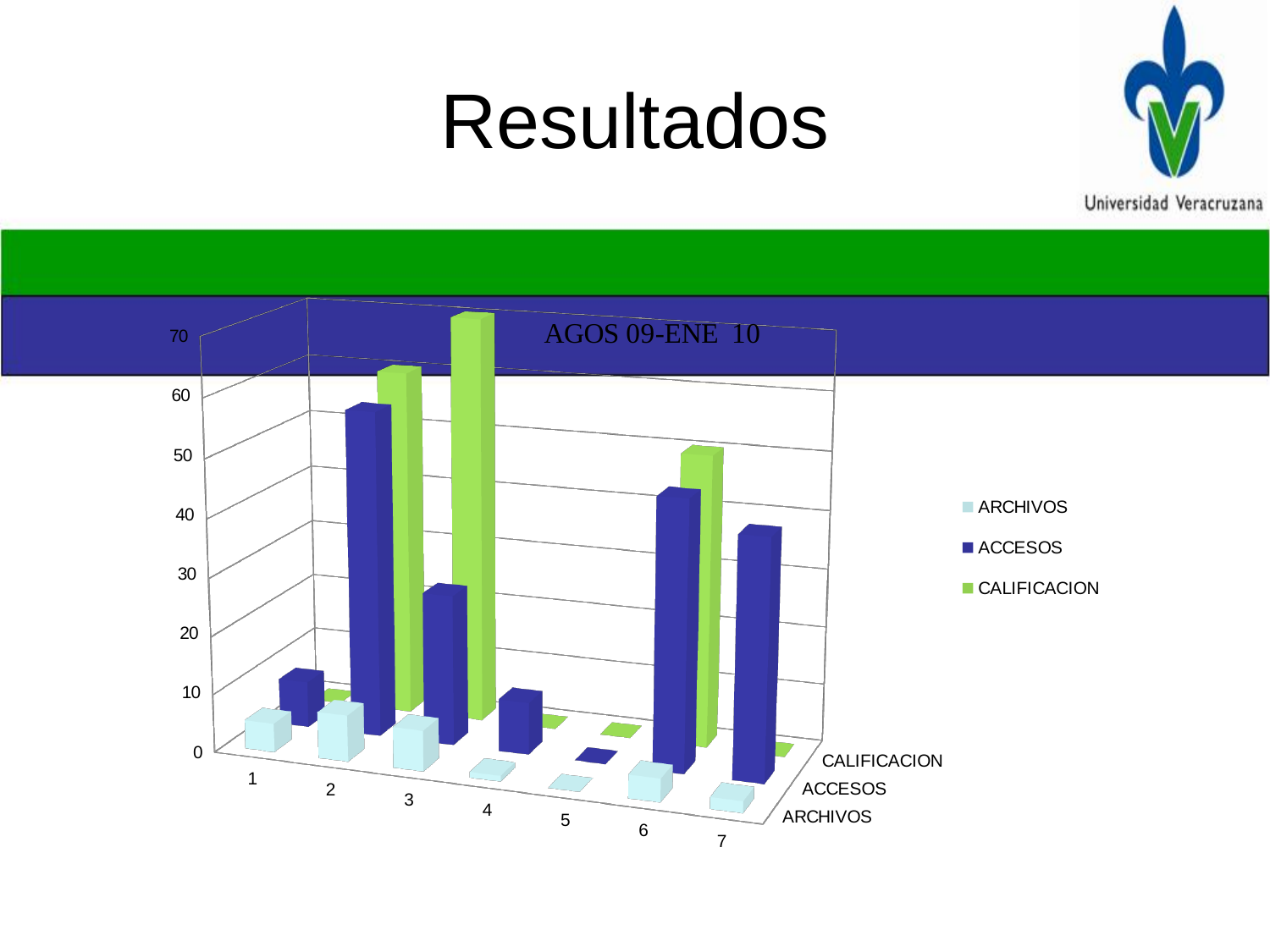
How many categories are shown along the x axis of the chart? 7 Is the CALIFICACION value for category 3 greater or less than 50? greater Is the CALIFICACION value for category 1 greater or less than 10? less Which series are listed in the chart legend? ARCHIVOS, ACCESOS, CALIFICACION Is the ACCESOS value for category 2 greater or less than 40? greater Which category has the highest CALIFICACION value? 3 Which category has the highest ACCESOS value? 2 Which is larger, the ACCESOS value for category 2 or the ACCESOS value for category 3? category 2 What kind of chart is shown on the slide? bar chart What is the title of the chart? AGOS 09-ENE 10 How many series does the chart legend list? 3